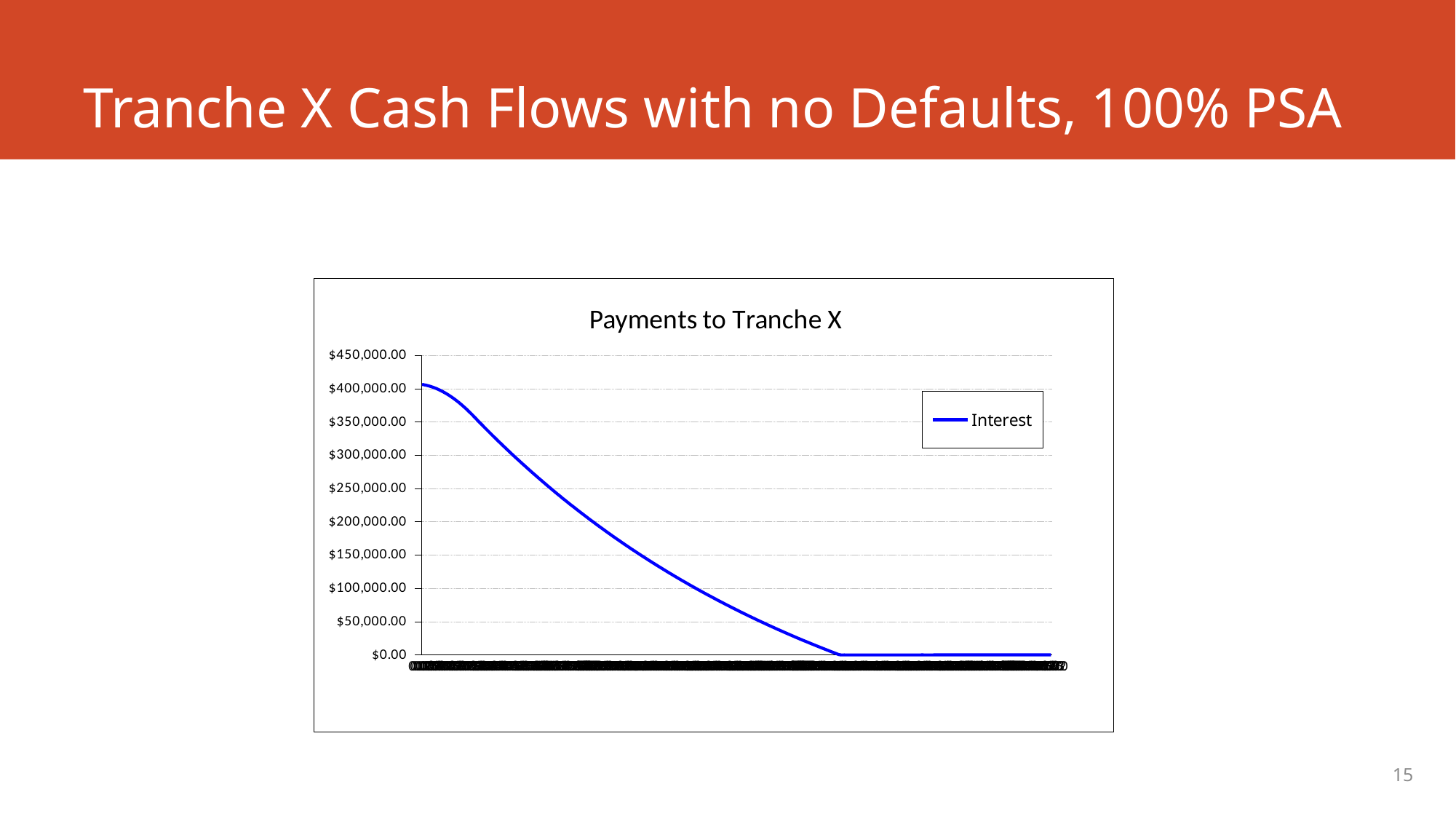
Is the Interest value at the end of the series greater or less than $50,000.00? less What series name appears in the chart's legend? Interest Is the Interest value at the start of the series greater or less than $450,000.00? less What is the title of the chart? Payments to Tranche X What kind of chart is shown on the slide? line chart Is the Interest value at the start of the series greater or less than $350,000.00? greater Do the Interest values rise or fall along the x axis? fall How many series does the legend of the chart list? 1 What is the highest value shown on the chart's vertical axis? $450,000.00